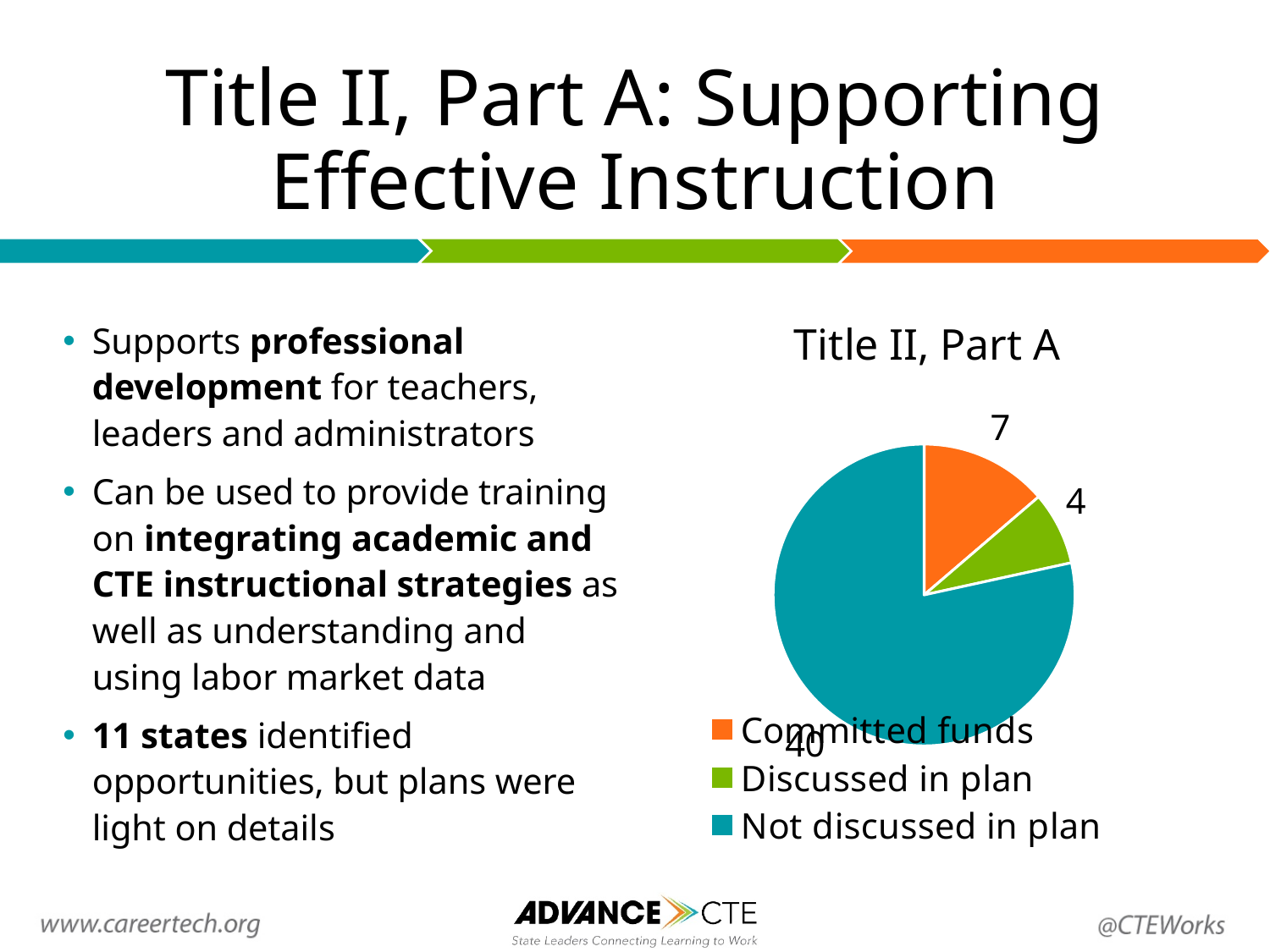
What is the value for Committed funds? 7 What type of chart is shown on the slide? Pie chart Which is larger, the value for Committed funds or the value for Discussed in plan? Committed funds Which category has the smallest slice of the pie? Discussed in plan What colour is the slice for Not discussed in plan? Teal What is the value for Not discussed in plan? 40 What is the difference between the values for Not discussed in plan and Committed funds? 33 How many entries does the chart legend list? 3 What is the title of the chart? Title II, Part A Which category has the largest slice of the pie? Not discussed in plan How many slices does the pie chart have? 3 What is the value for Discussed in plan? 4